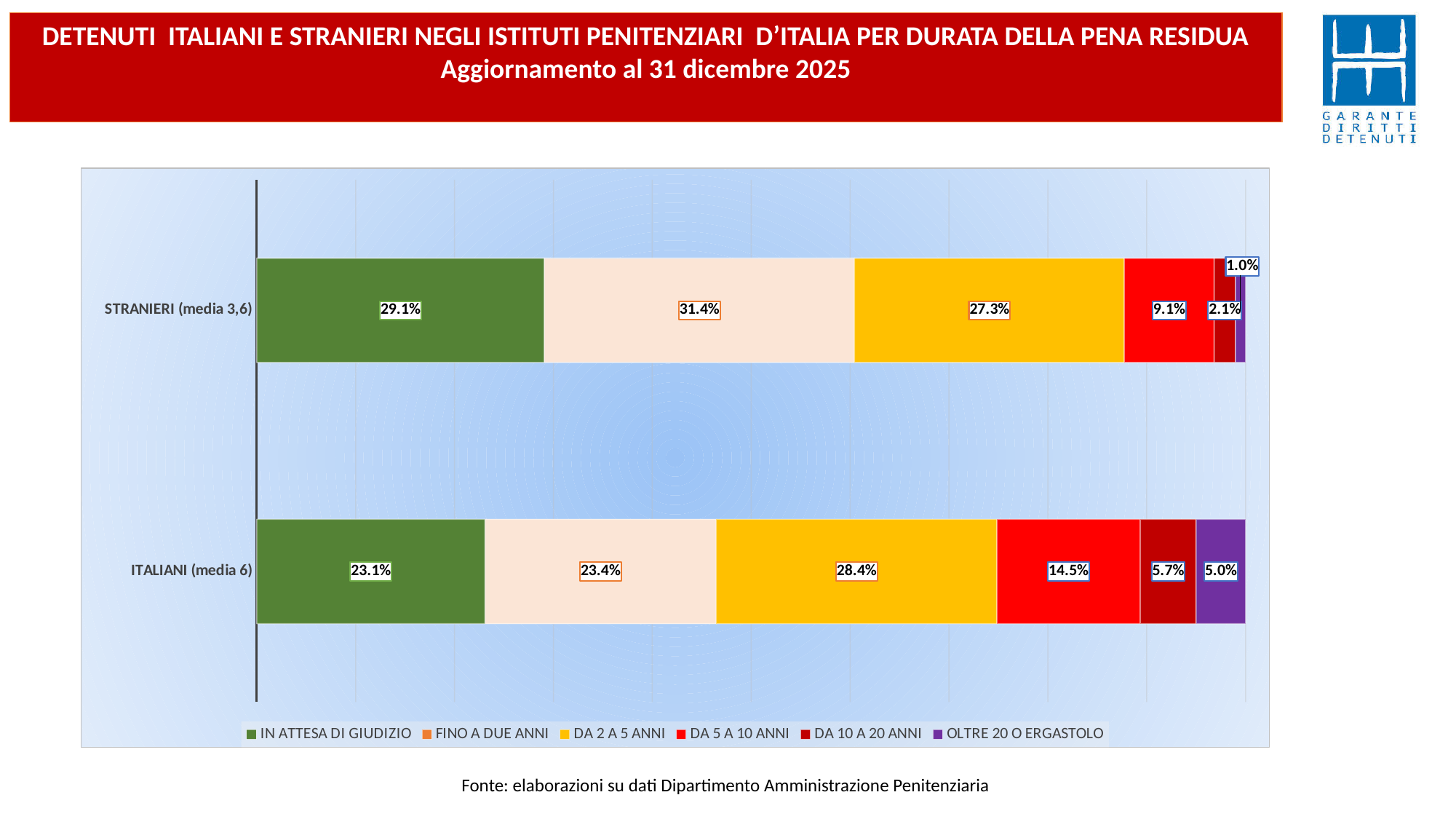
Which series has the largest segment in the STRANIERI (media 3,6) bar? FINO A DUE ANNI How much larger is the DA 5 A 10 ANNI value for ITALIANI (media 6) than for STRANIERI (media 3,6)? 5.4 percentage points What is the value for DA 5 A 10 ANNI in the ITALIANI (media 6) bar? 14.5% How many series does the legend list? 6 What is the value for OLTRE 20 O ERGASTOLO in the STRANIERI (media 3,6) bar? 1.0% What kind of chart is shown on the slide? Stacked bar chart What is the total of the STRANIERI (media 3,6) stacked bar? 100.0% Which series has the largest segment in the ITALIANI (media 6) bar? DA 2 A 5 ANNI How many bars (categories) are shown in the chart? 2 Which series has the smallest segment in the ITALIANI (media 6) bar? OLTRE 20 O ERGASTOLO Which bar has the larger IN ATTESA DI GIUDIZIO value, STRANIERI (media 3,6) or ITALIANI (media 6)? STRANIERI (media 3,6) What is the value for IN ATTESA DI GIUDIZIO in the STRANIERI (media 3,6) bar? 29.1%